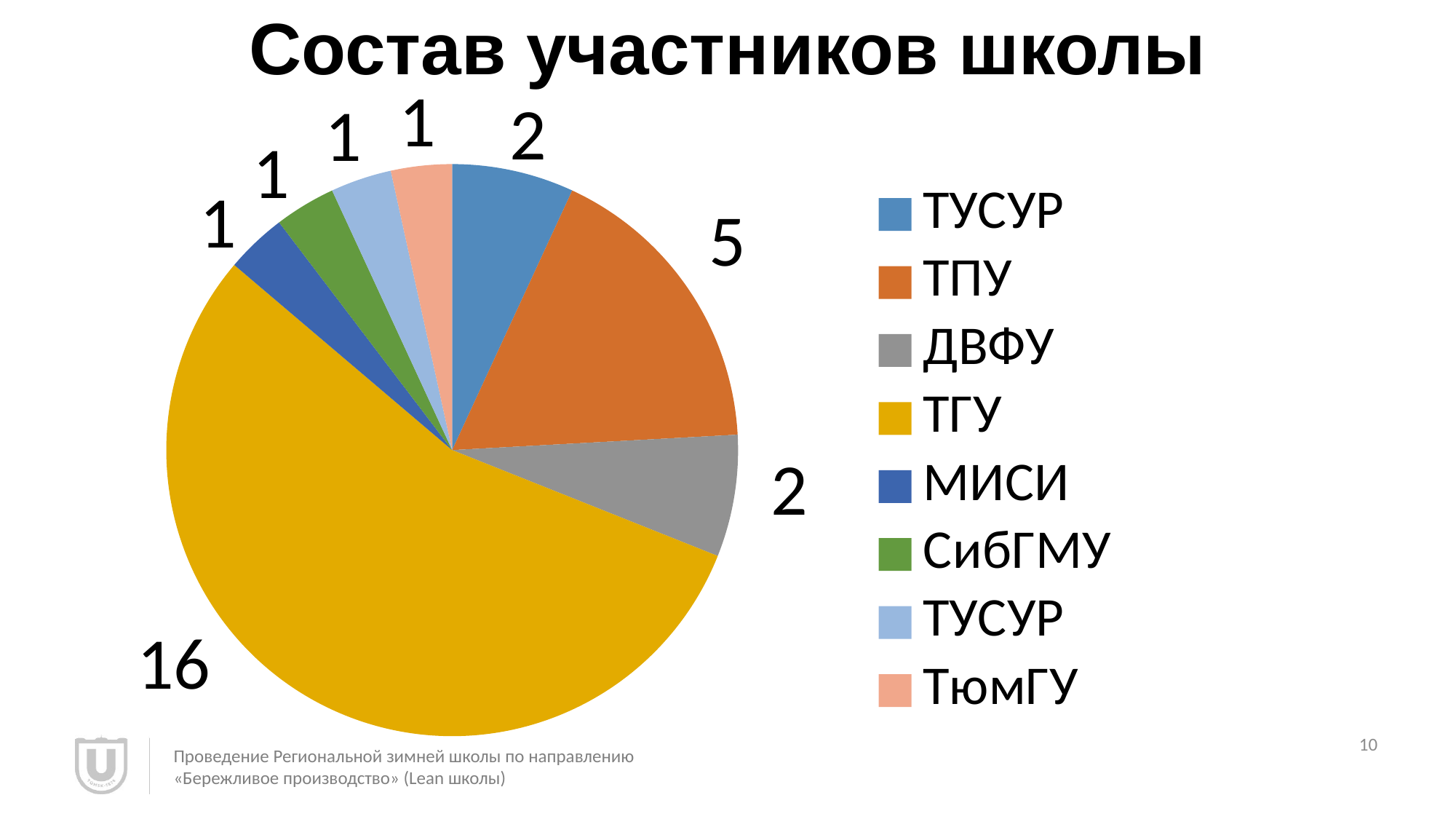
Which category has the largest slice of the pie? ТГУ How many entries does the legend list? 8 What is the value for ТюмГУ? 1 What is the difference between the values for ТГУ and ТПУ? 11 What type of chart is shown on the slide? pie chart What is the value for ДВФУ? 2 How many slices does the pie chart have? 8 Which is larger, the value for ТПУ or the value for ДВФУ? ТПУ What is the value for МИСИ? 1 What is the value for ТПУ? 5 What is the value for ТГУ? 16 What is the title of the chart? Состав участников школы